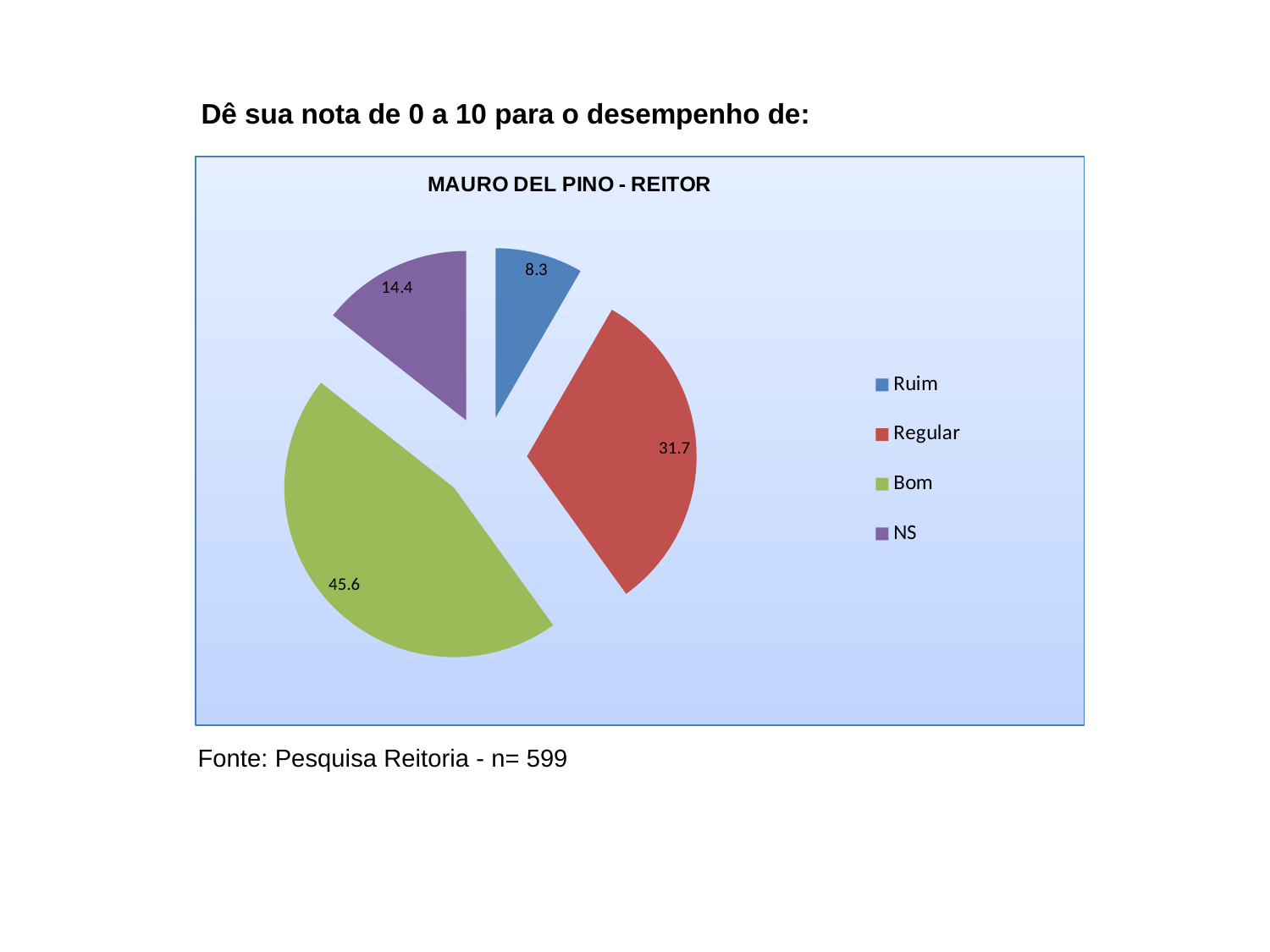
What kind of chart is shown on the slide? Pie chart Which is larger, the value for NS or the value for Ruim? NS What colour is the slice for Regular? Red Which category has the smallest slice? Ruim How many slices does the pie chart have? 4 Which category has the largest slice? Bom What is the value for Regular? 31.7 What is the value for Bom? 45.6 What is the value for NS? 14.4 What is the difference between the values for Bom and Regular? 13.9 What is the title of the chart? MAURO DEL PINO - REITOR What is the value for Ruim? 8.3